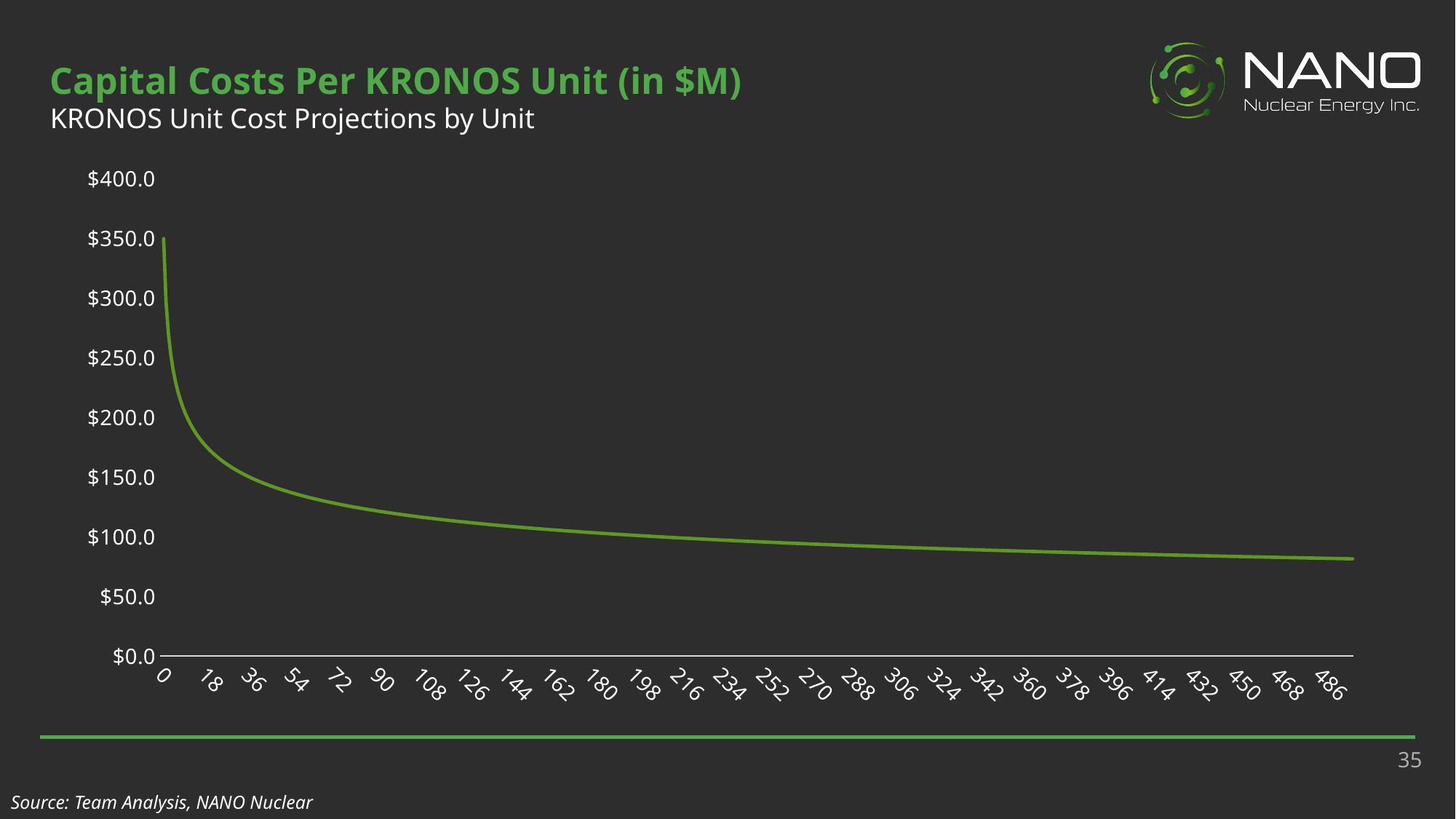
What is the highest value labelled on the y axis? $400.0 Is the value at unit 486 greater or less than $100.0? less What is the title of the chart? Capital Costs Per KRONOS Unit (in $M) Do the capital costs per unit rise or fall as the unit number increases along the x axis? fall Is the value at unit 270 greater or less than $150.0? less What kind of chart is shown on the slide? line chart Is the value at unit 90 greater or less than $100.0? greater Which unit number has the highest capital cost, 0 or 486? 0 How many tick labels are shown on the x axis? 28